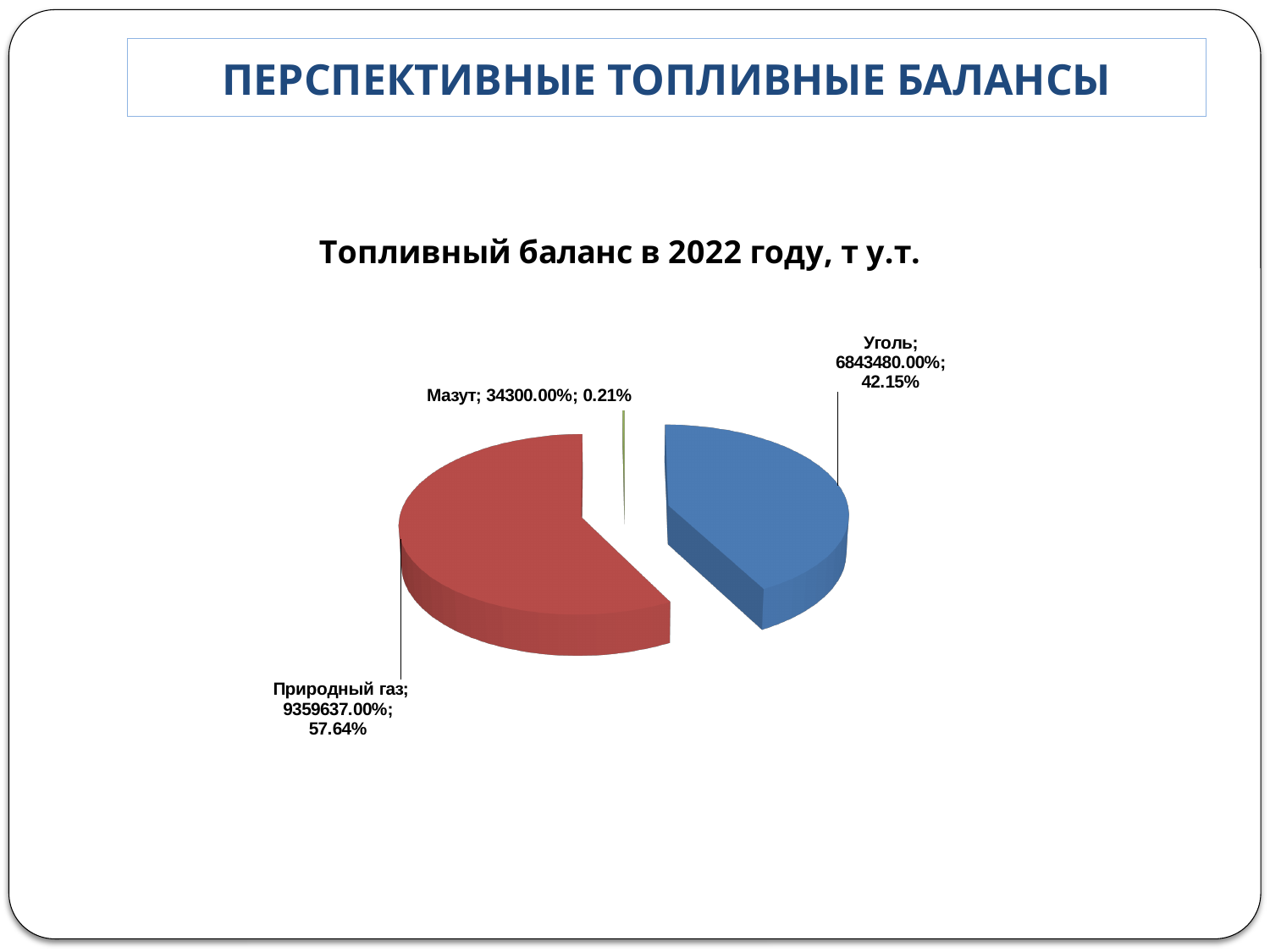
What is the title of the chart? Топливный баланс в 2022 году, т у.т. Which is larger, the slice for Природный газ or the slice for Уголь? Природный газ What share of the pie does Природный газ represent? 57.64% What share of the pie does Мазут represent? 0.21% Which category has the smallest slice of the pie? Мазут How many slices does the pie chart have? 3 What share of the pie does Уголь represent? 42.15% What value is printed for Уголь? 6843480.00% What kind of chart is shown on the slide? Pie chart Which category has the largest slice of the pie? Природный газ What value is printed for Природный газ? 9359637.00% What is the difference in percentage points between the share of Природный газ and the share of Уголь? 15.49%